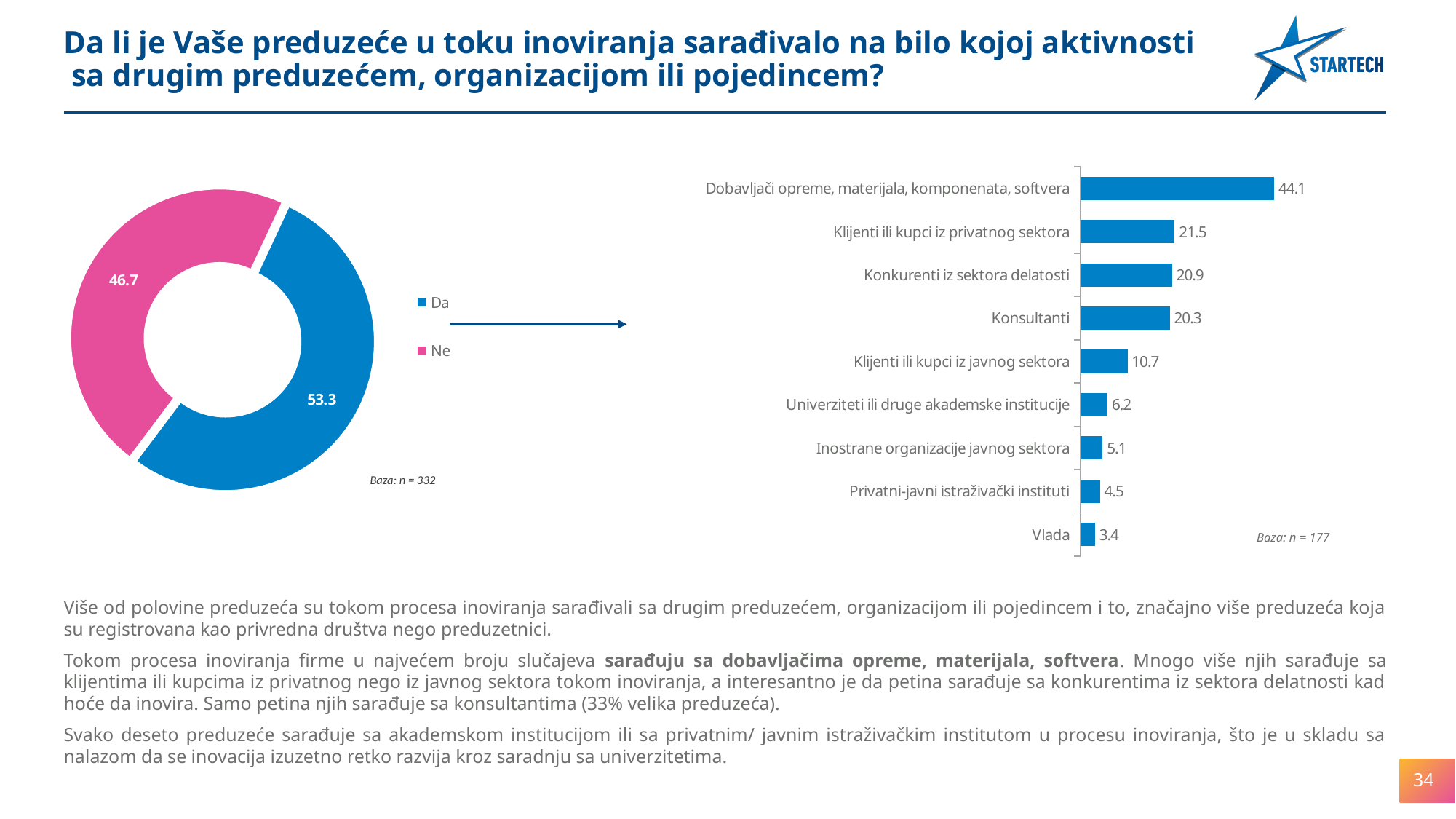
How many categories are shown in the bar chart on the right? 9 In the doughnut chart on the left, what is the value for "Ne"? 46.7 In the bar chart on the right, what is the difference between "Klijenti ili kupci iz privatnog sektora" and "Klijenti ili kupci iz javnog sektora"? 10.8 In the bar chart on the right, what is the value for "Univerziteti ili druge akademske institucije"? 6.2 In the doughnut chart on the left, which segment is larger, "Da" or "Ne"? Da How many entries does the legend of the doughnut chart on the left list? 2 In the bar chart on the right, which category has the lowest value? Vlada In the doughnut chart on the left, what is the difference between the "Da" and "Ne" values? 6.6 In the bar chart on the right, which category has the highest value? Dobavljači opreme, materijala, komponenata, softvera What type of chart is shown on the right side of the slide? Bar chart In the bar chart on the right, what is the value for "Konsultanti"? 20.3 In the doughnut chart on the left, what is the value for "Da"? 53.3